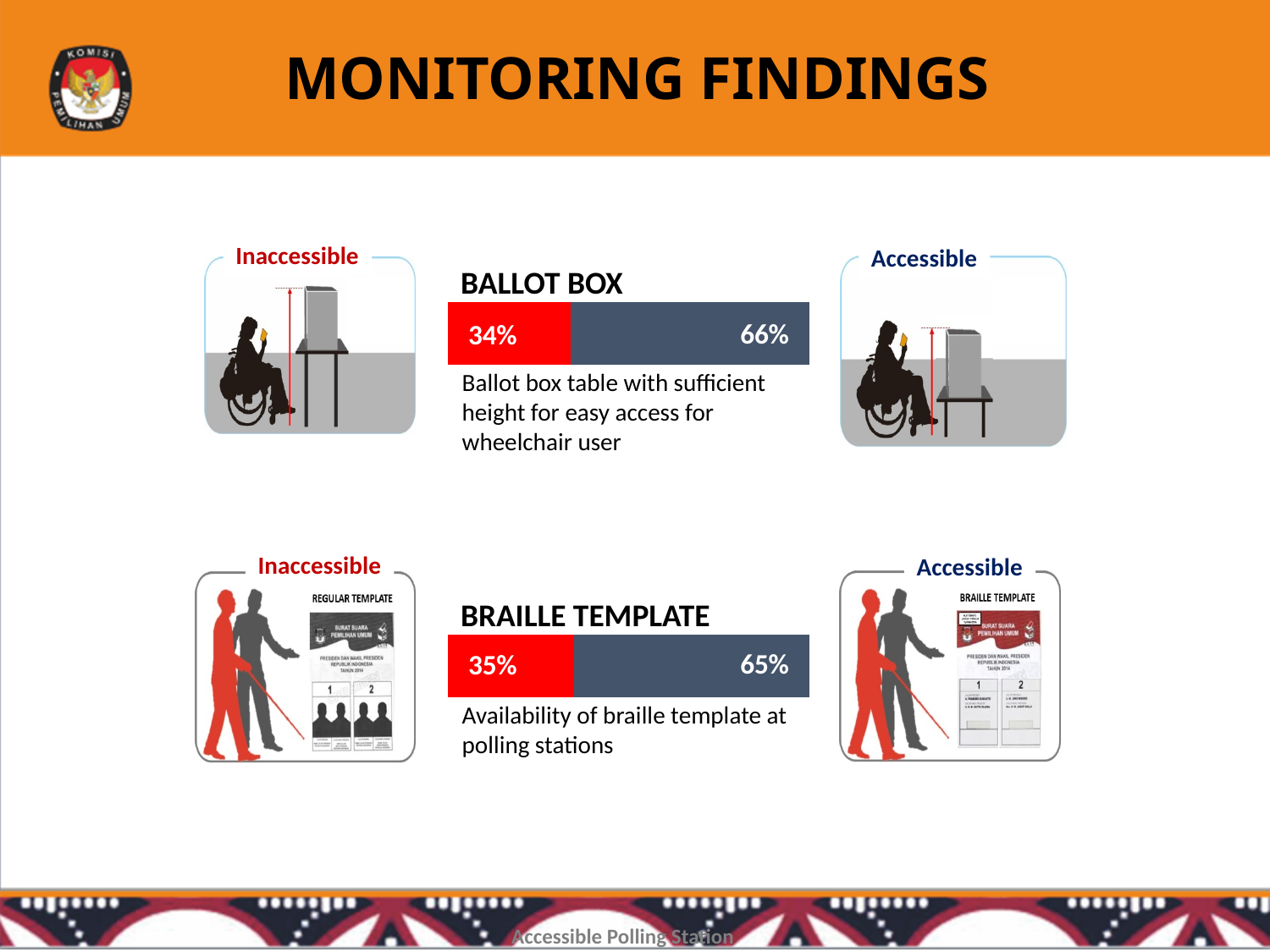
In the BRAILLE TEMPLATE chart, which segment is smaller, Inaccessible or Accessible? Inaccessible In the BALLOT BOX chart, what percentage is shown in the red (Inaccessible) segment? 34% In the BALLOT BOX chart, what is the difference between the Accessible and Inaccessible percentages? 32% Which chart has the larger Inaccessible percentage, BALLOT BOX or BRAILLE TEMPLATE? BRAILLE TEMPLATE In the BALLOT BOX chart, what percentage is shown in the dark (Accessible) segment? 66% In the BALLOT BOX chart, which segment is larger, the 34% segment or the 66% segment? 66% How many segments does the BRAILLE TEMPLATE bar contain? 2 What is the total of the two segments in the BALLOT BOX bar? 100% In the BRAILLE TEMPLATE chart, what is the difference between the Accessible and Inaccessible percentages? 30% In the BRAILLE TEMPLATE chart, what percentage is shown in the red (Inaccessible) segment? 35% What kind of chart is used for the BALLOT BOX data? Stacked bar chart In the BRAILLE TEMPLATE chart, what percentage is shown in the dark (Accessible) segment? 65%